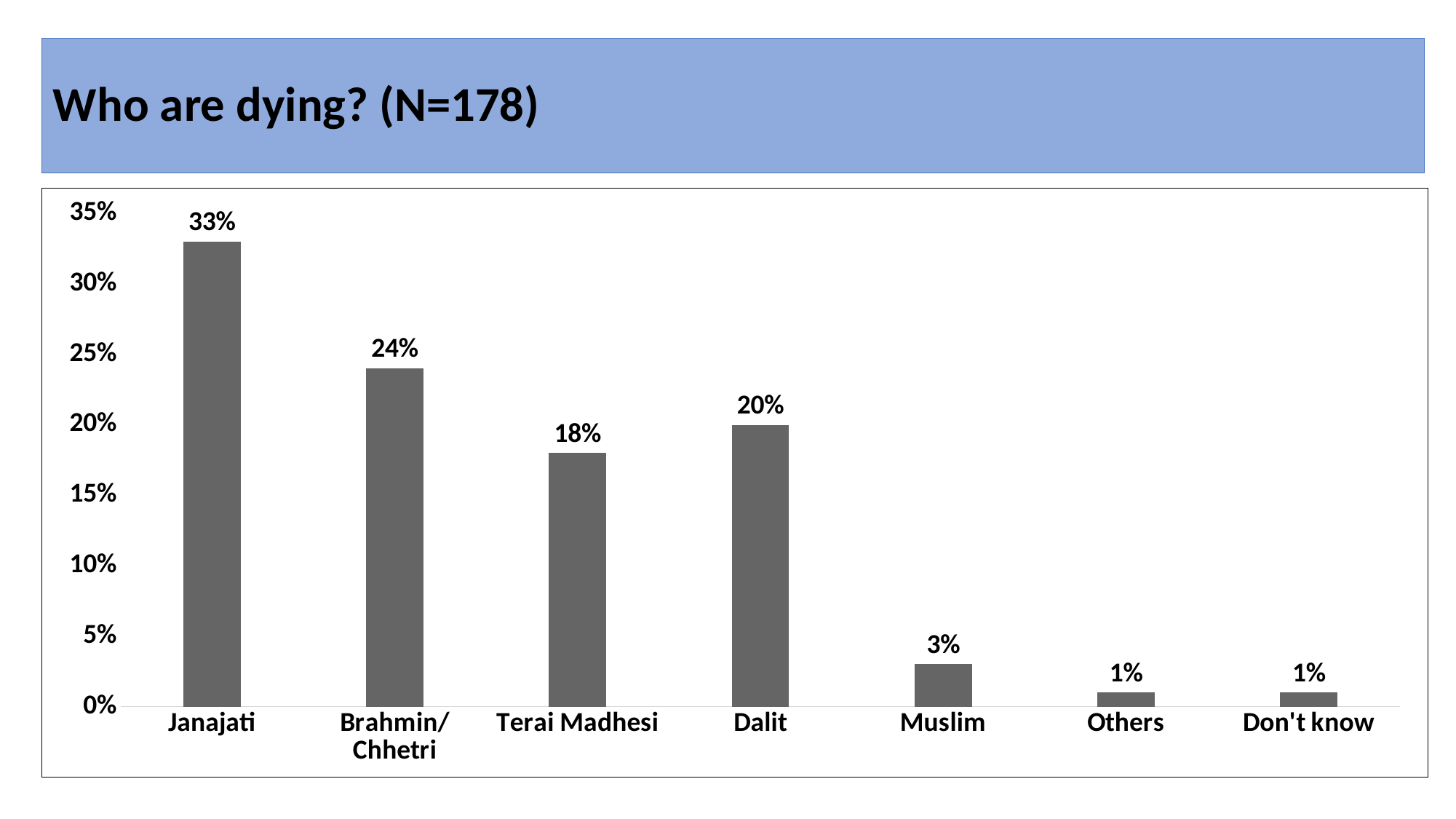
Which is larger, the value for Dalit or the value for Terai Madhesi? Dalit How many categories are shown on the x axis? 7 What is the value for Brahmin/Chhetri? 24% What is the value for Janajati? 33% What is the difference between the values for Dalit and Terai Madhesi? 2% What kind of chart is shown on the slide? Bar chart Which category has the highest value? Janajati What is the title of the slide? Who are dying? (N=178) What is the value for Terai Madhesi? 18% What is the value for Dalit? 20% What is the difference between the values for Janajati and Brahmin/Chhetri? 9% What is the value for Muslim? 3%